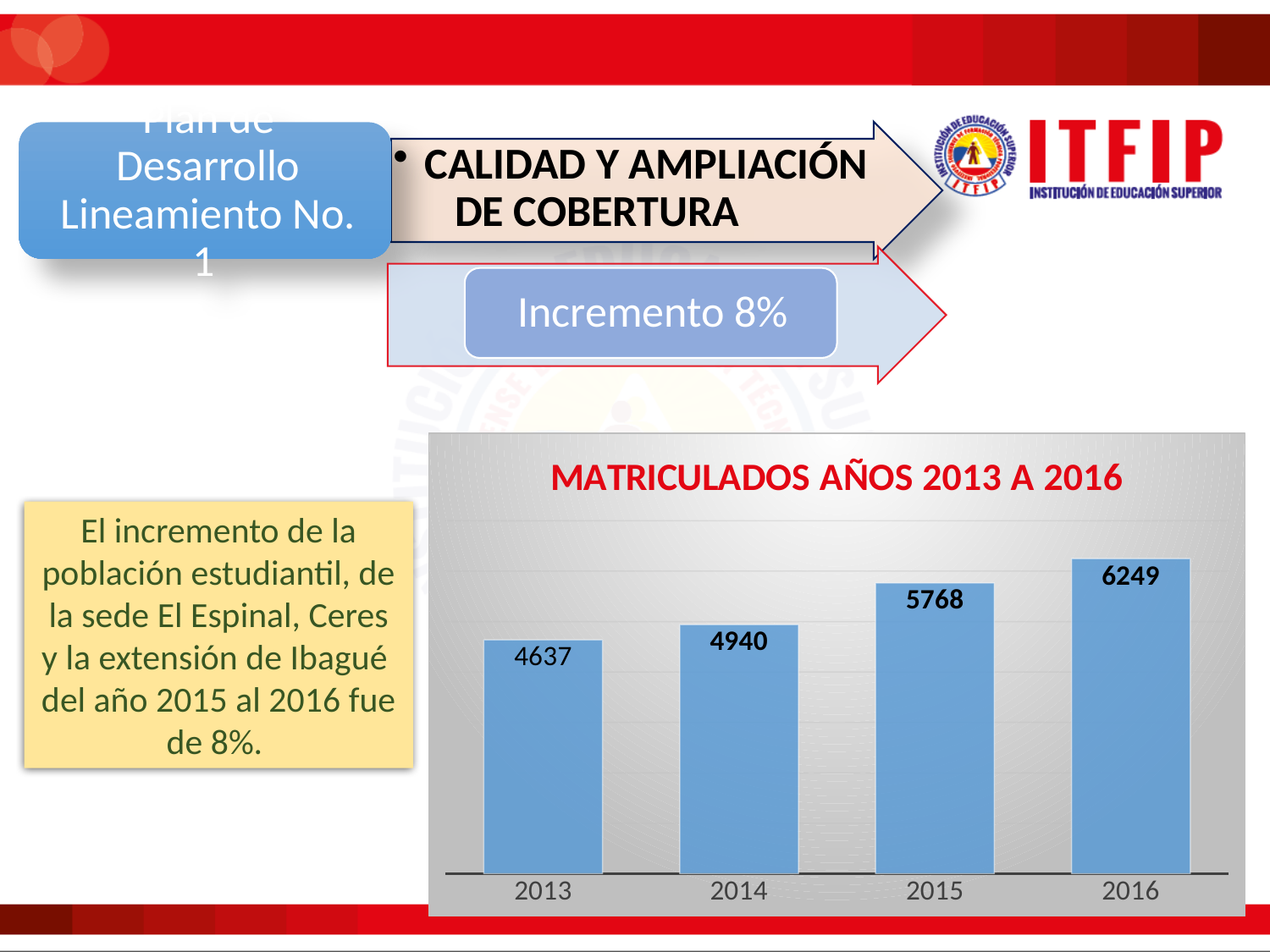
What kind of chart is shown on the slide? bar chart What is the difference between the values for 2014 and 2013? 303 How many years are shown in the chart? 4 Which is larger, the value for 2014 or the value for 2015? 2015 What is the value for 2015 in the chart? 5768 What is the value for 2016 in the chart? 6249 Do the values rise or fall from 2013 to 2016? rise What is the value for 2014 in the chart? 4940 What is the value for 2013 in the MATRICULADOS AÑOS 2013 A 2016 chart? 4637 Which year has the lowest number of matriculados? 2013 Which year has the highest number of matriculados? 2016 What is the difference between the values for 2016 and 2015? 481